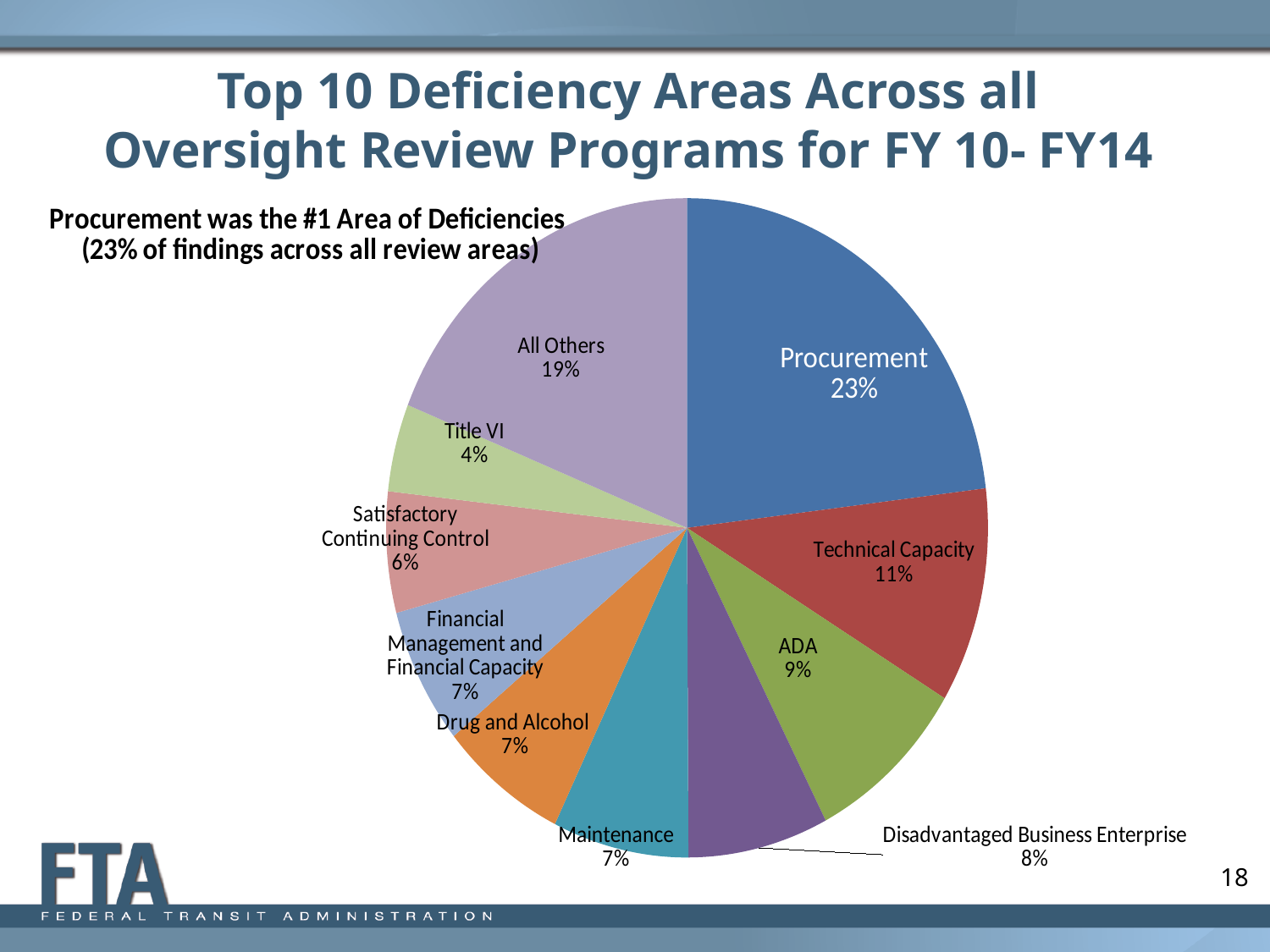
What kind of chart is shown on the slide? Pie chart Which named deficiency area has the smallest slice of the pie? Title VI How many percentage points larger is Procurement's share than Technical Capacity's share? 12 What is the title of the slide containing the chart? Top 10 Deficiency Areas Across all Oversight Review Programs for FY 10- FY14 Which has a larger share, ADA or Disadvantaged Business Enterprise? ADA Which deficiency area has the largest slice of the pie? Procurement What share of the pie is labelled All Others? 19% How many slices does the pie chart have? 10 What percentage is shown for Satisfactory Continuing Control? 6% What share of findings does Procurement account for in the pie chart? 23% What percentage is shown for Disadvantaged Business Enterprise? 8% What percentage is shown for Technical Capacity? 11%